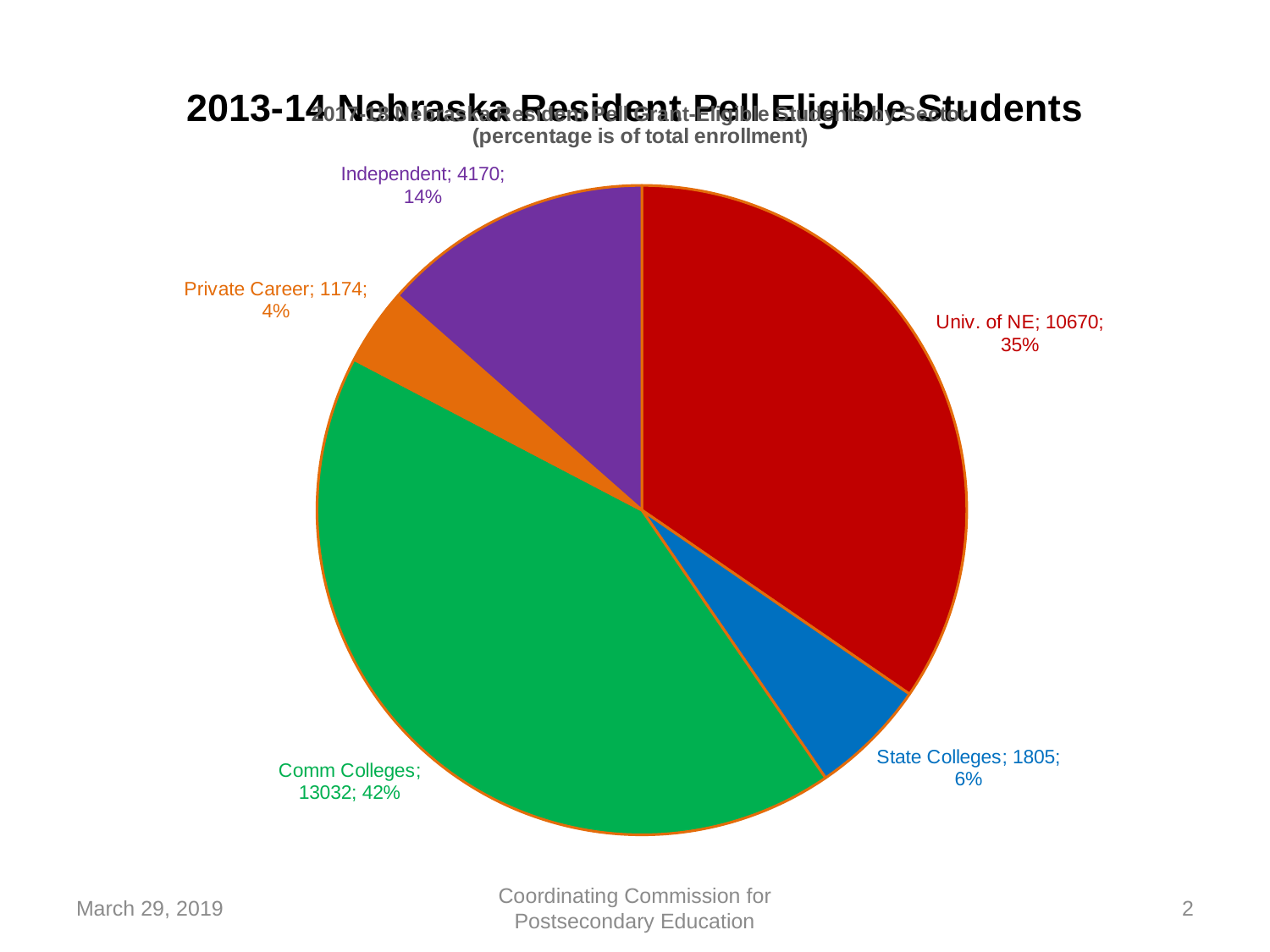
What percentage is shown for Private Career? 4% Which sector has the smallest slice of the pie? Private Career Which sector has the largest slice of the pie? Comm Colleges How many sectors (slices) does the pie chart show? 5 What colour is the Univ. of NE slice? red How many students are shown for Independent? 4170 Which has more students, State Colleges or Independent? Independent How many Pell eligible students are shown for Comm Colleges? 13032 What percentage of total enrollment is shown for Univ. of NE? 35% What percentage is shown for State Colleges? 6% What is the difference in student counts between Comm Colleges and Univ. of NE? 2362 What kind of chart is shown on the slide? pie chart